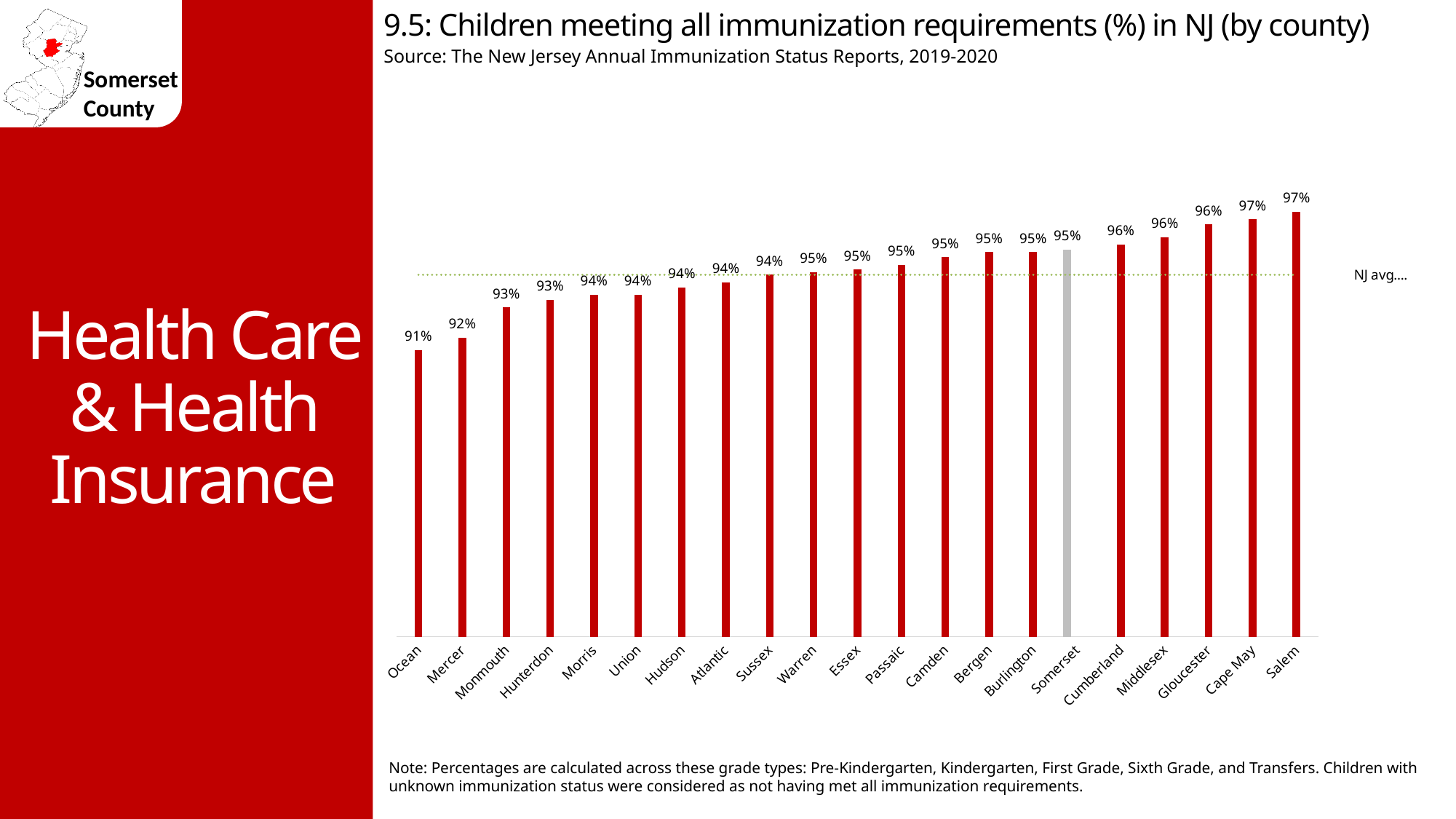
What is the difference in percentage points between Salem and Ocean? 6 percentage points What does the dotted horizontal line across the chart represent? NJ avg. What is the value shown for Hunterdon County? 93% What type of chart is shown on the slide? Bar chart What is the value shown for Ocean County? 91% What percentage of children in Somerset County met all immunization requirements? 95% Which county has the lowest percentage of children meeting all immunization requirements? Ocean Which county's bar is coloured grey instead of red? Somerset How many counties are shown on the chart? 21 What is the value shown for Gloucester County? 96% Which county has a higher value, Cumberland or Hunterdon? Cumberland Do the values generally rise or fall moving from left to right along the x axis? Rise